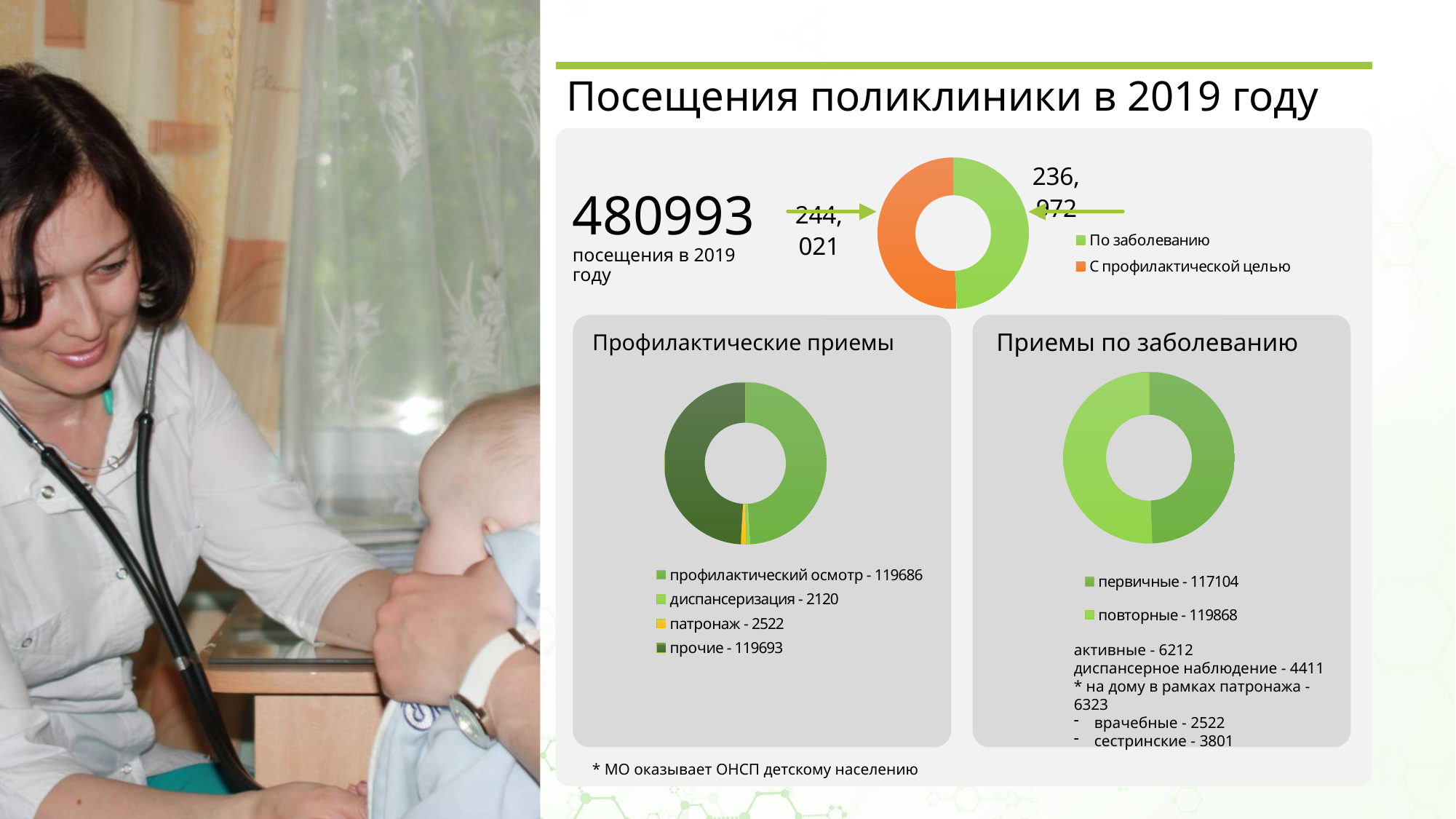
In the 'Приемы по заболеванию' chart, what is the difference between 'повторные' and 'первичные'? 2764 How many categories does the legend of the 'Профилактические приемы' chart list? 4 In the 'Приемы по заболеванию' chart, what is the value for 'повторные'? 119868 How many series does the legend of the top chart list? 2 In the top chart, what is the value for 'С профилактической целью'? 244,021 In the 'Профилактические приемы' chart, what colour represents 'патронаж'? Yellow In the 'Профилактические приемы' chart, which category has the lowest value? диспансеризация What type of chart is used in the 'Профилактические приемы' panel? Doughnut (pie) chart In the 'Профилактические приемы' chart, what is the value for 'патронаж'? 2522 In the 'Приемы по заболеванию' chart, what is the value for 'первичные'? 117104 In the 'Профилактические приемы' chart, what is the value for 'диспансеризация'? 2120 In the top chart, which is larger: 'По заболеванию' or 'С профилактической целью'? С профилактической целью